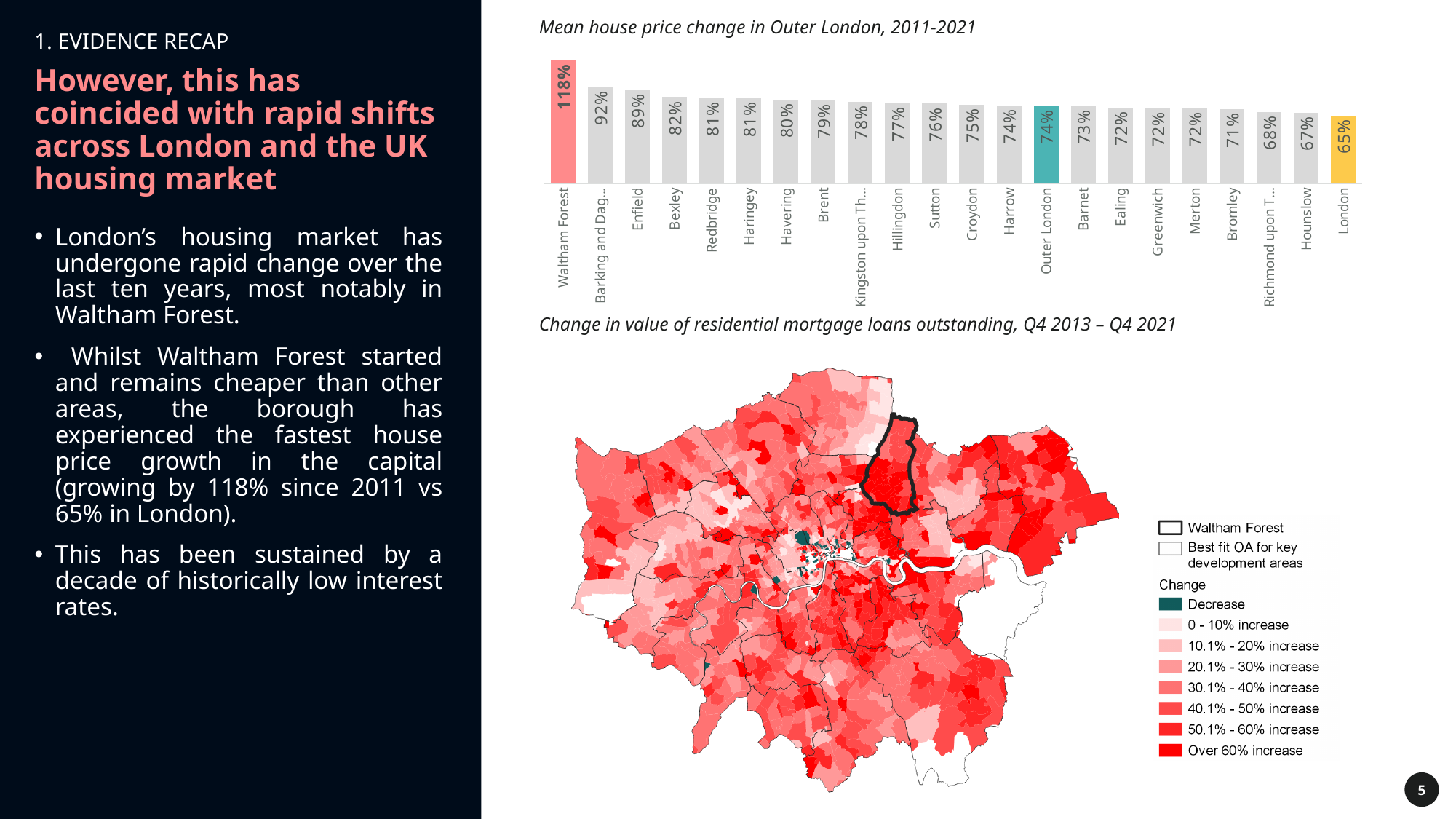
In the 'Mean house price change in Outer London, 2011-2021' chart, how many bars are shown? 22 In the 'Mean house price change in Outer London, 2011-2021' chart, do the values rise or fall from left to right? Fall In the 'Mean house price change in Outer London, 2011-2021' chart, which is larger, the value for Havering or the value for Sutton? Havering In the 'Mean house price change in Outer London, 2011-2021' chart, what is the value for Outer London? 74% In the 'Mean house price change in Outer London, 2011-2021' chart, what is the difference between the values for Waltham Forest and London? 53% In the 'Mean house price change in Outer London, 2011-2021' chart, what is the value for Hounslow? 67% In the 'Mean house price change in Outer London, 2011-2021' chart, what is the difference between the values for Bexley and Bromley? 11% What kind of chart is the 'Mean house price change in Outer London, 2011-2021' chart? Bar chart In the 'Mean house price change in Outer London, 2011-2021' chart, which category has the lowest value? London In the 'Mean house price change in Outer London, 2011-2021' chart, what is the value for Waltham Forest? 118% In the 'Mean house price change in Outer London, 2011-2021' chart, what is the value for Enfield? 89% In the 'Mean house price change in Outer London, 2011-2021' chart, which category has the highest value? Waltham Forest